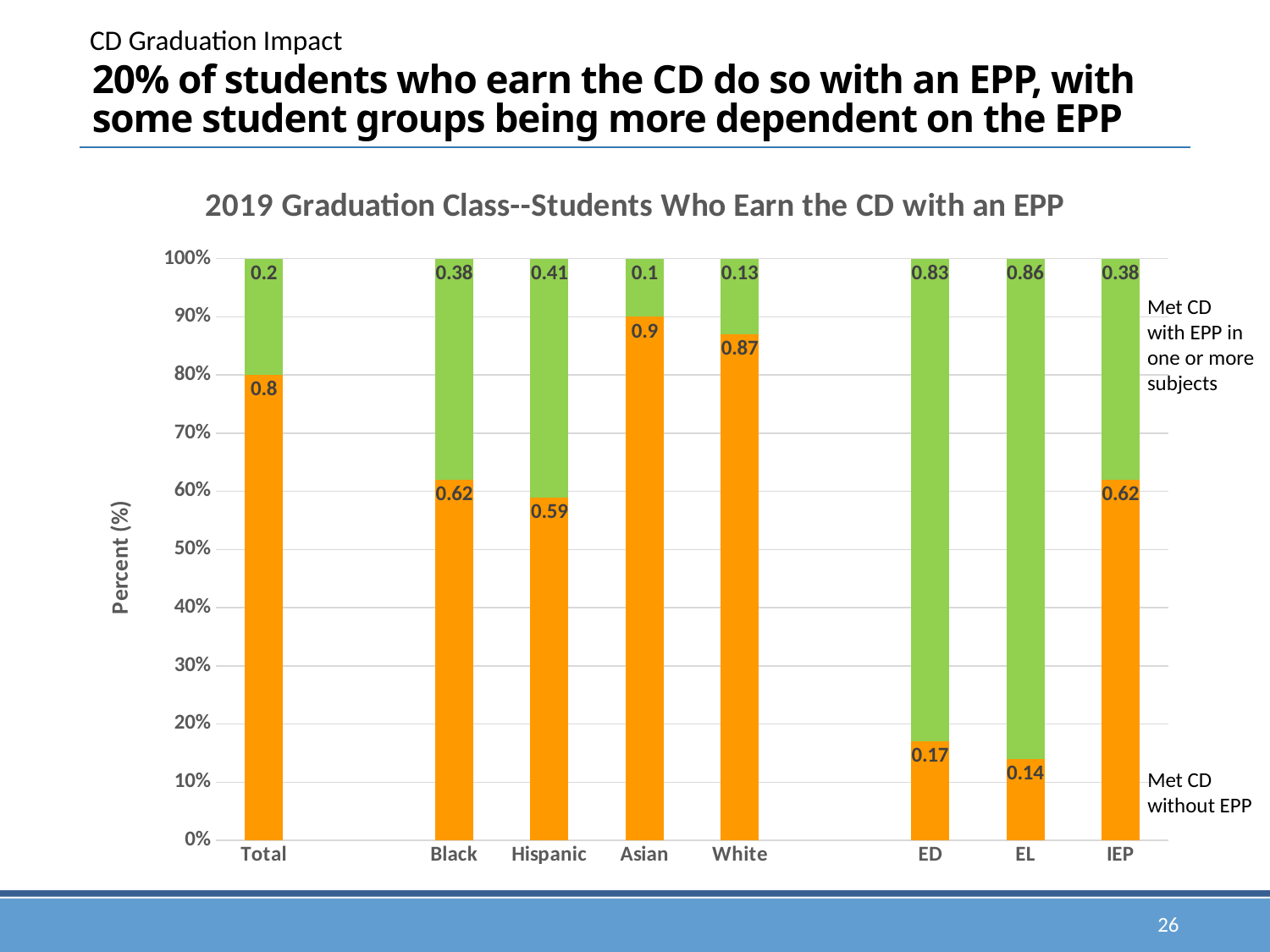
What is the value labelled for the Met CD with EPP segment for EL students? 0.86 Which group has the lowest labelled value for Met CD with EPP? Asian Is the Met CD without EPP segment for ED students greater or less than 20%? less What is the chart title? 2019 Graduation Class--Students Who Earn the CD with an EPP Which group has the highest labelled value for Met CD with EPP? EL What is the value labelled for the Met CD with EPP segment for the Total group? 0.2 How many student groups are shown on the x axis of the chart? 8 What is the value labelled for the Met CD without EPP segment for Hispanic students? 0.59 What type of chart is shown on the slide? stacked bar chart What is the difference between the Met CD without EPP values for Asian and White students? 0.03 Which is larger, the Met CD with EPP value for Black students or for Hispanic students? Hispanic What is the y-axis title of the chart? Percent (%)